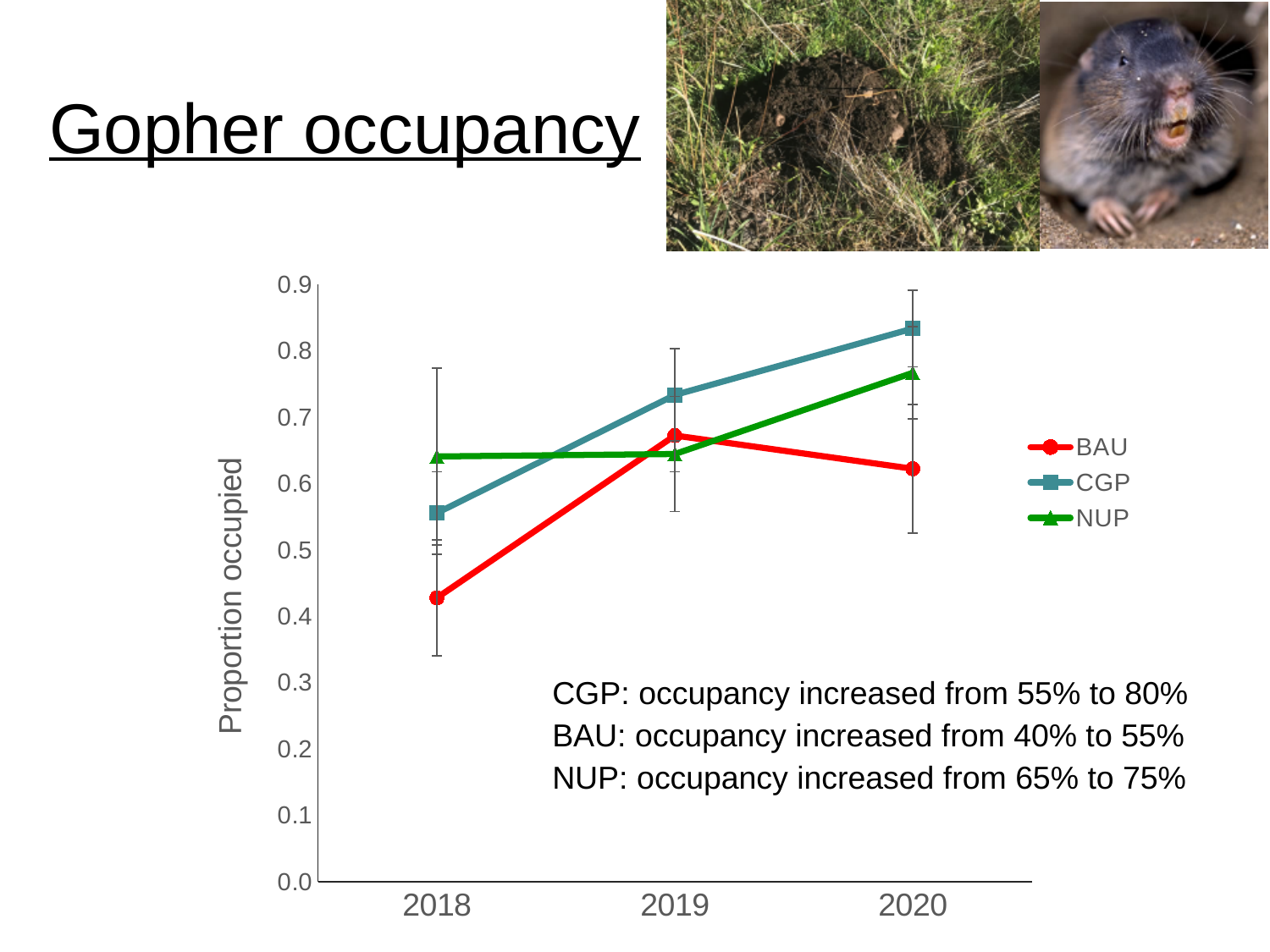
What type of chart is shown on the slide? Line chart Does the proportion occupied for CGP rise or fall from 2018 to 2020? Rise In 2019, which series has the higher proportion occupied, CGP or BAU? CGP Is the proportion occupied for CGP in 2020 greater or less than 0.8? greater Which series has the highest proportion occupied in 2020? CGP What is the label of the y axis? Proportion occupied In 2018, which series has the higher proportion occupied, NUP or CGP? NUP How many years are shown on the x axis? 3 Which series has the lowest proportion occupied in 2018? BAU Is the proportion occupied for BAU in 2018 greater or less than 0.5? less Is the proportion occupied for NUP in 2020 greater or less than 0.7? greater How many series does the legend list? 3